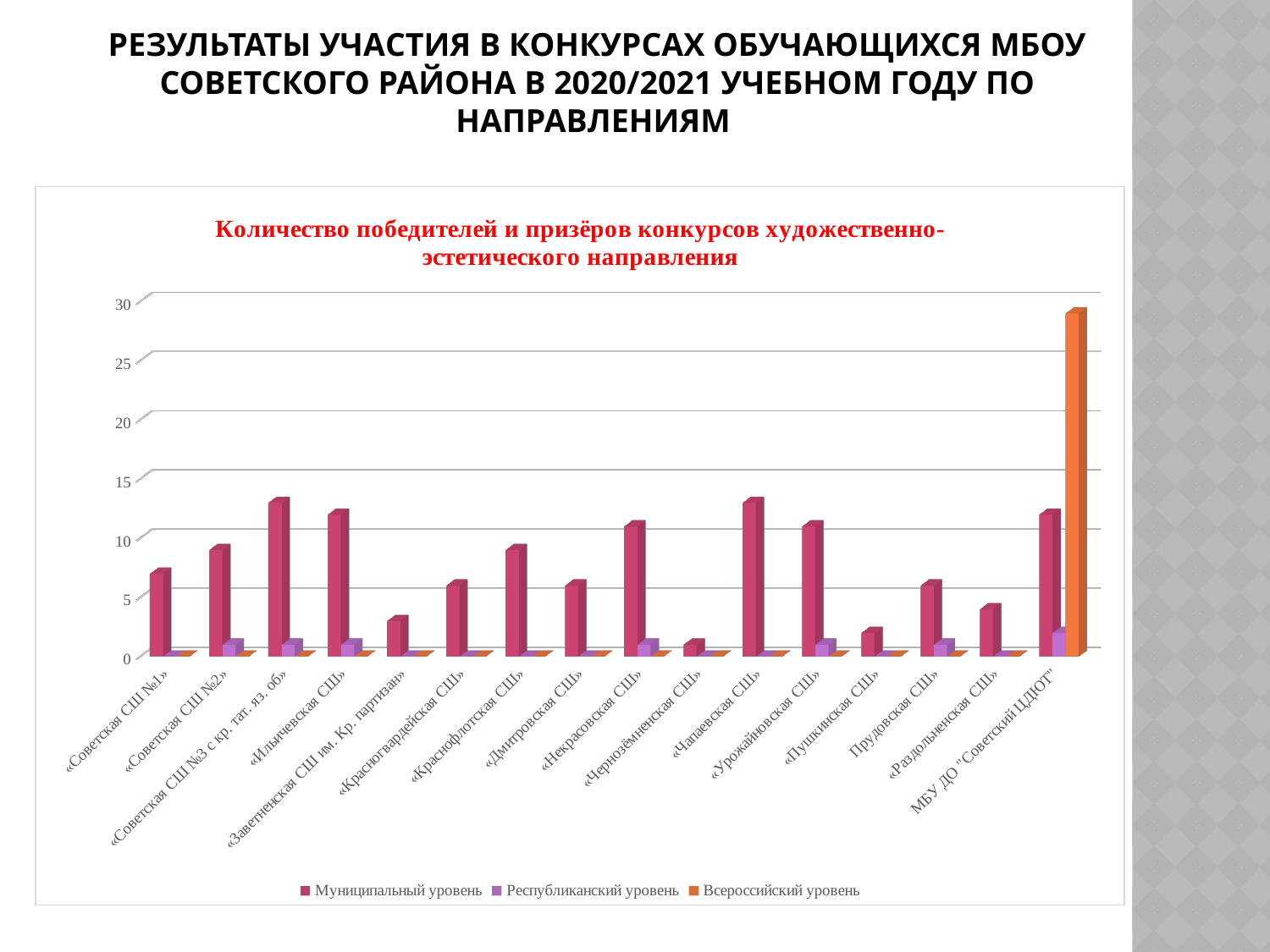
How many series does the legend list? 3 Is the Всероссийский уровень value for МБУ ДО "Советский ЦДЮТ" greater or less than 25? greater Is the Муниципальный уровень value for «Советская СШ №3 с кр. тат. яз. об» greater or less than 10? greater How many schools (categories) are shown on the x axis? 16 Is the Муниципальный уровень value for «Ильичевская СШ» greater or less than 10? greater Which has the larger Муниципальный уровень value: «Некрасовская СШ» or «Пушкинская СШ»? «Некрасовская СШ» Which has the larger Муниципальный уровень value: «Советская СШ №2» or «Заветненская СШ им. Кр. партизан»? «Советская СШ №2» What kind of chart is shown on the slide? bar chart Which school has the lowest value for Муниципальный уровень? «Чернозёмненская СШ» Which series is shown in orange in the legend? Всероссийский уровень Which school has the tallest bar in the whole chart? МБУ ДО "Советский ЦДЮТ"